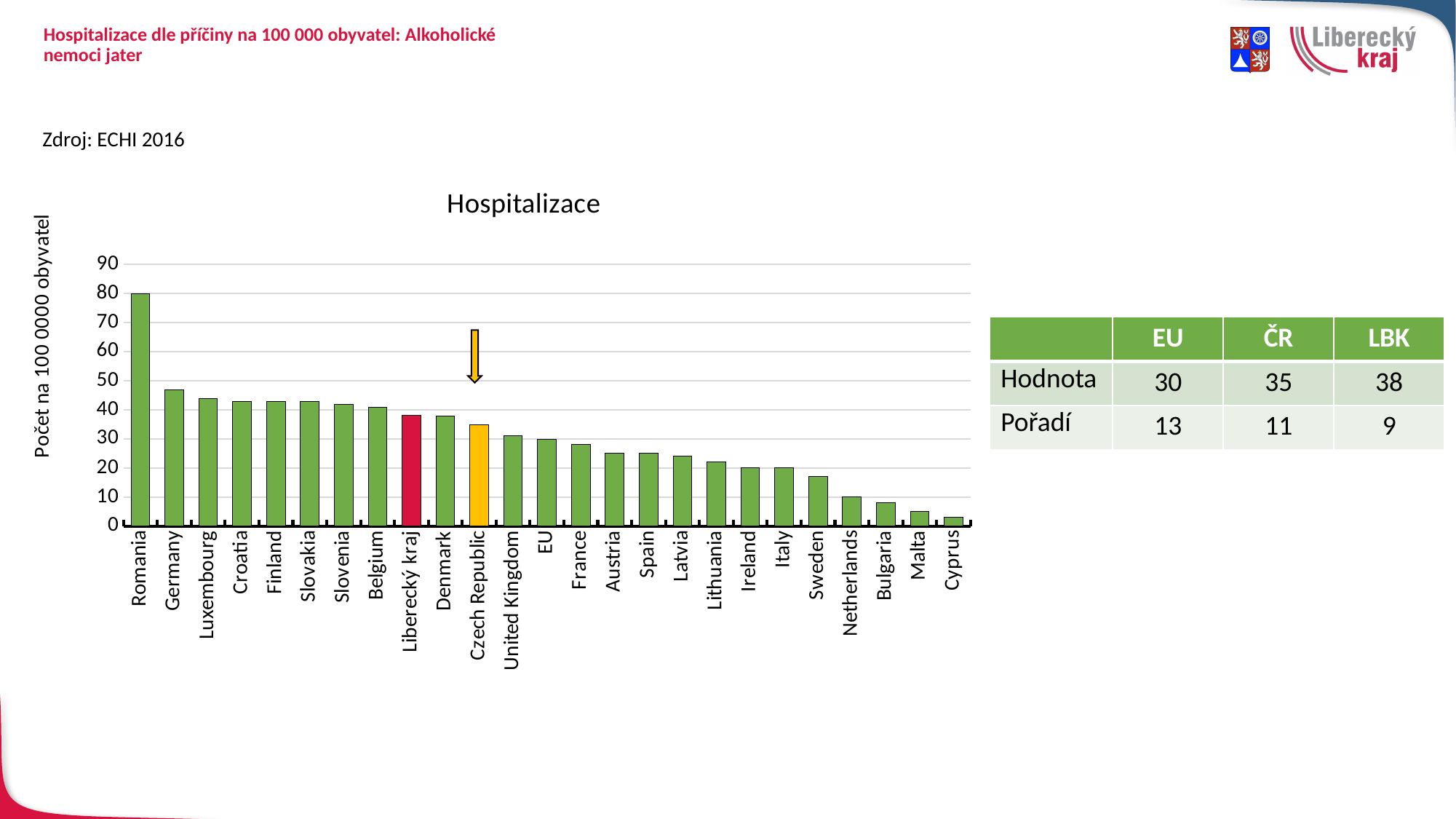
Do the values rise or fall from left to right along the x axis of the Hospitalizace chart? fall According to the table on the slide, what is the value (Hodnota) for EU? 30 Which category has the lowest value in the Hospitalizace chart? Cyprus What kind of chart is shown on the slide? bar chart Is the value for Romania greater or less than 70? greater Using the table values, what is the difference between the LBK value and the EU value? 8 Is the value for Germany greater or less than 50? less Is the value for Cyprus greater or less than 10? less Which country has the highest value in the Hospitalizace chart? Romania According to the table on the slide, what is the value (Hodnota) for LBK (Liberecký kraj)? 38 Which has the larger value in the Hospitalizace chart, Germany or Sweden? Germany How many categories (bars) are plotted in the Hospitalizace chart? 25